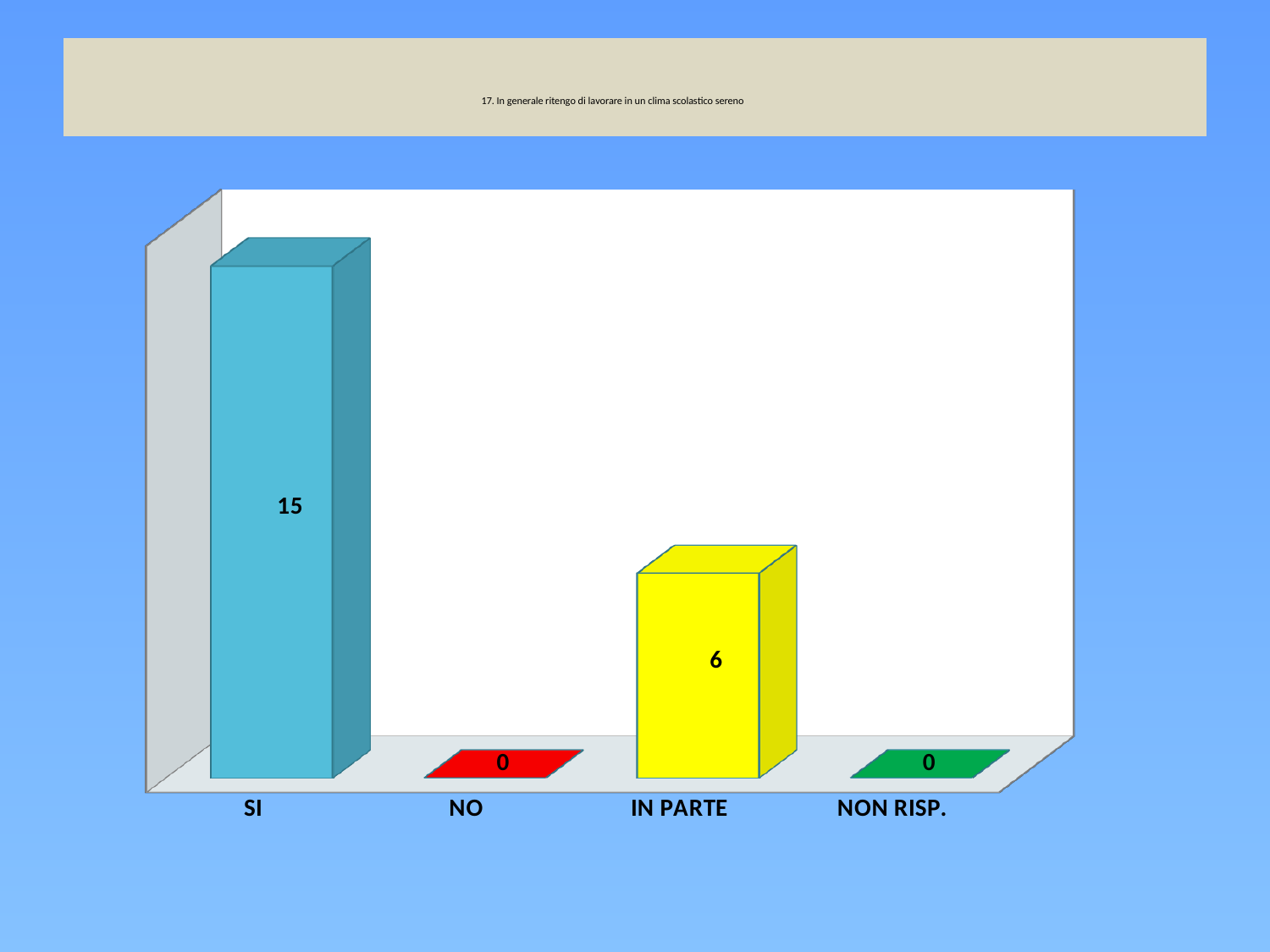
What kind of chart is shown on the slide? bar chart What is the value for SI? 15 What is the difference between the values for SI and IN PARTE? 9 How many categories are shown on the x axis? 4 What is the value for NON RISP.? 0 Which category has the highest value? SI What is the total of all the values shown in the chart? 21 What is the value for IN PARTE? 6 What is the title text shown above the chart? 17. In generale ritengo di lavorare in un clima scolastico sereno Which is larger, the value for SI or the value for IN PARTE? SI What colour is the bar for IN PARTE? yellow What is the value for NO? 0